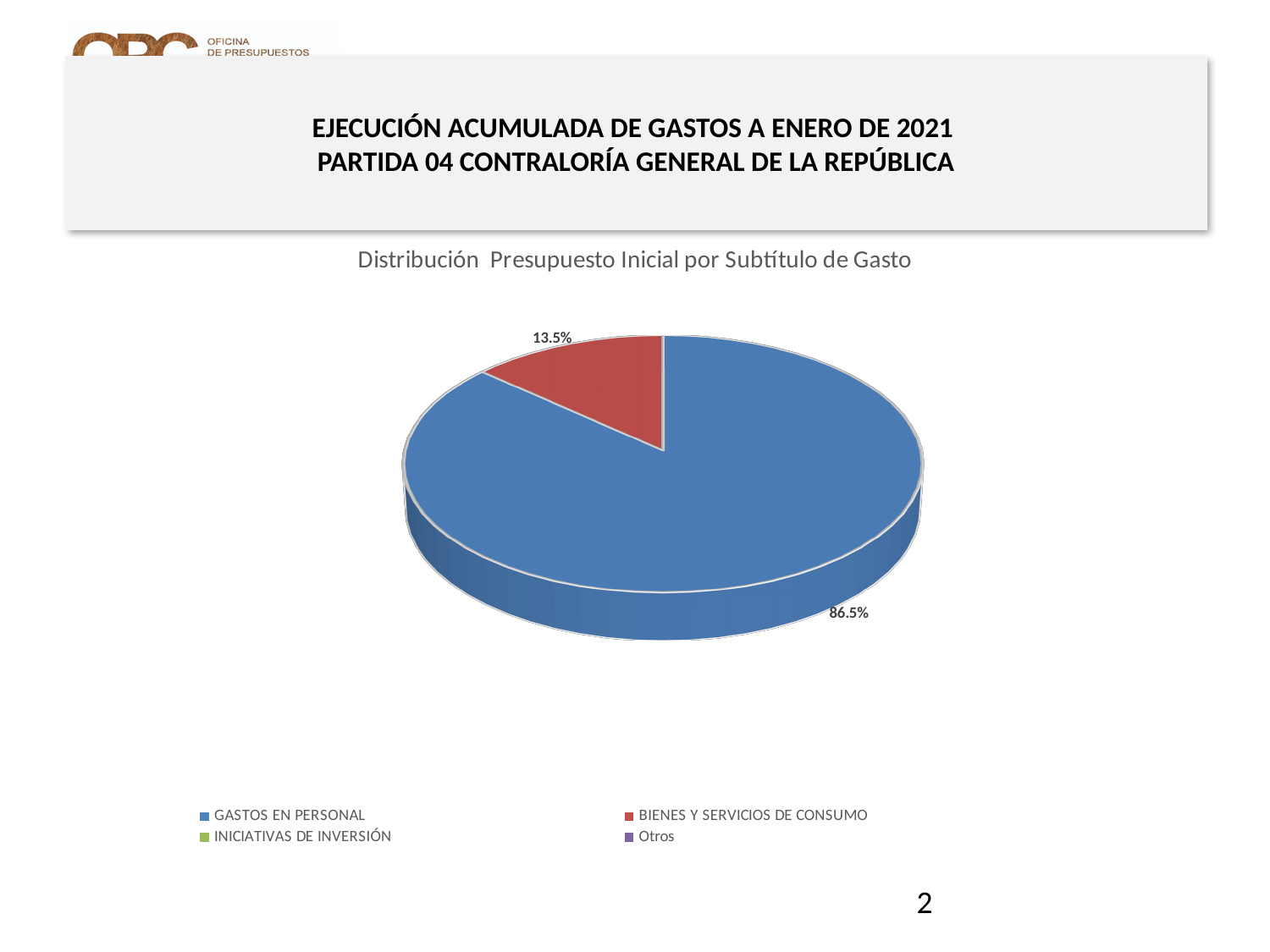
What is the title of the chart? Distribución Presupuesto Inicial por Subtítulo de Gasto What share of the pie does BIENES Y SERVICIOS DE CONSUMO represent? 13.5% What kind of chart is shown on the slide? pie chart Which is larger, the slice for GASTOS EN PERSONAL or the slice for BIENES Y SERVICIOS DE CONSUMO? GASTOS EN PERSONAL Which category has the largest slice of the pie? GASTOS EN PERSONAL What colour is the slice for BIENES Y SERVICIOS DE CONSUMO? red How many slices have a percentage label printed on the pie? 2 How many entries does the legend list? 4 What share of the pie does GASTOS EN PERSONAL represent? 86.5% What do the two labelled slices add up to? 100.0% Which of the two labelled slices is the smallest? BIENES Y SERVICIOS DE CONSUMO What is the difference in percentage points between the GASTOS EN PERSONAL slice and the BIENES Y SERVICIOS DE CONSUMO slice? 73.0%